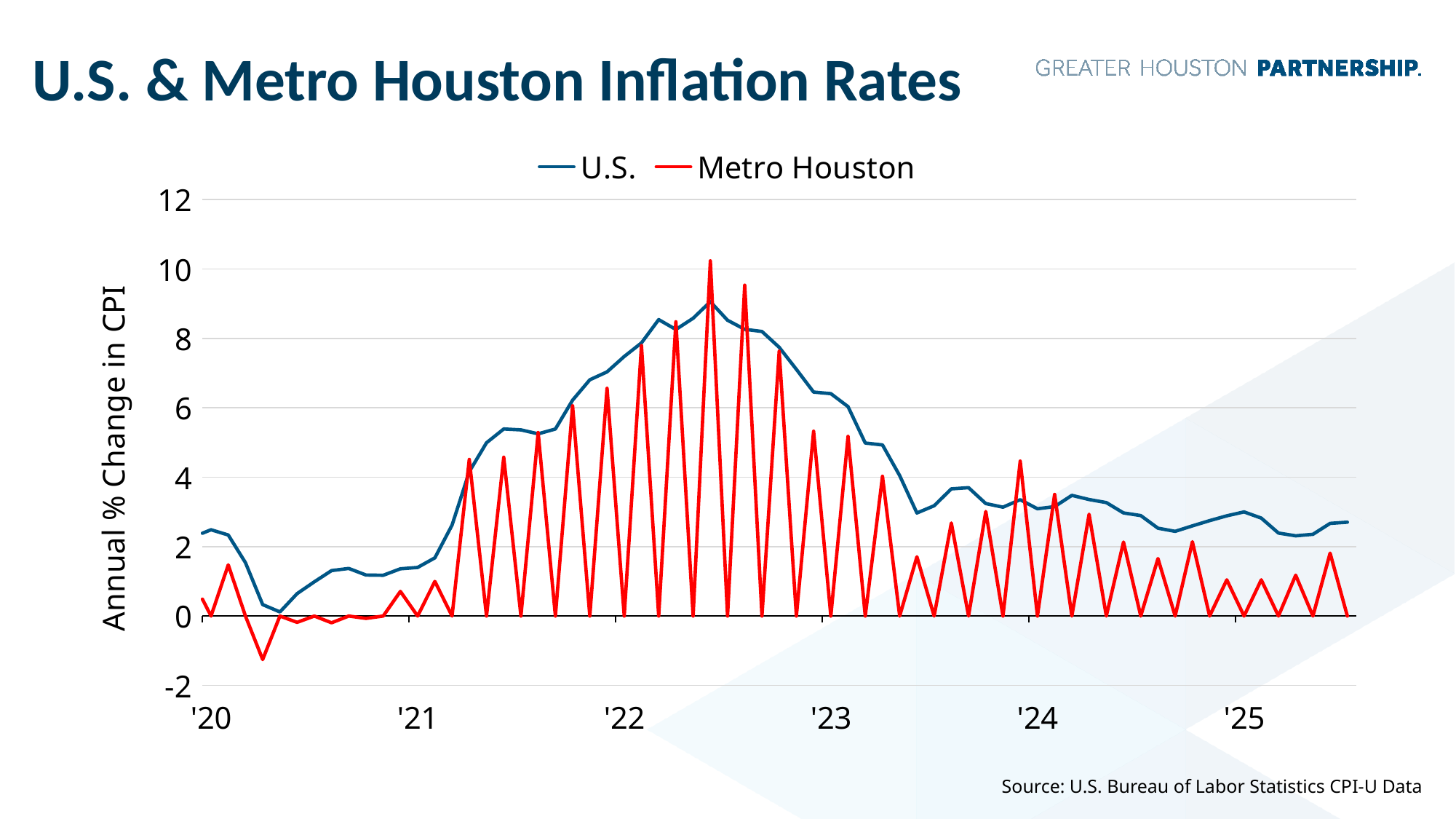
Is the value of the U.S. series at the start of '24 greater or less than 4? less How many series does the legend list? 2 Which series reaches the highest peak on the chart? Metro Houston Is the peak value of the U.S. series in 2022 greater or less than 8? greater How many year labels are shown on the x axis? 6 Is the value of the U.S. series at the start of '23 greater or less than 6? greater What is the title of the chart? U.S. & Metro Houston Inflation Rates Does the U.S. series rise or fall between the start of '22 and the start of '23? Fall What is the label on the vertical axis? Annual % Change in CPI What kind of chart is shown on the slide? Line chart